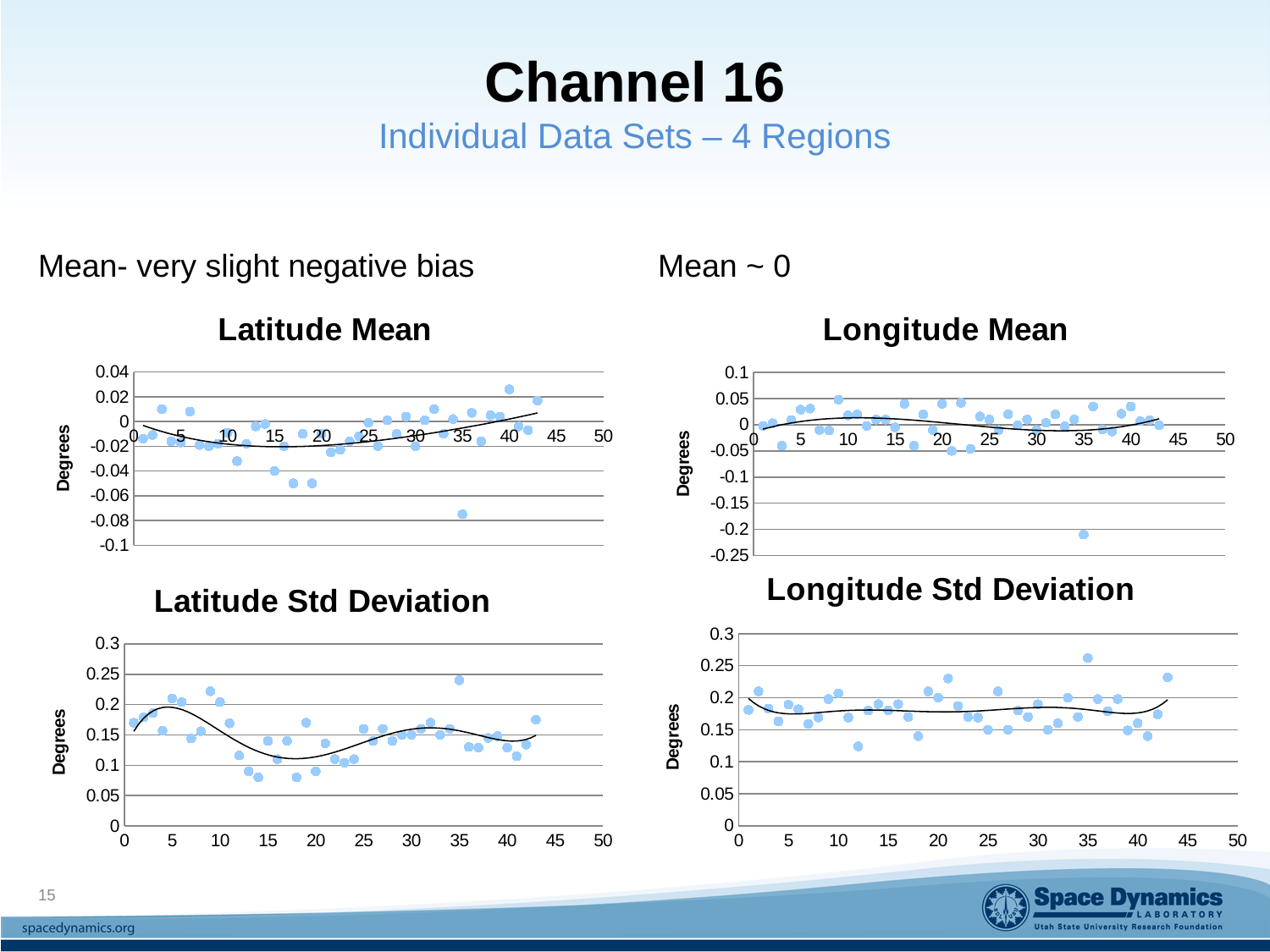
What is the title of the top-right chart? Longitude Mean In the Latitude Std Deviation chart, is the lowest plotted point greater or less than 0.1? less What kind of chart is the Longitude Std Deviation chart? scatter chart In the Longitude Mean chart, is the lowest plotted point greater or less than -0.15? less What is the y-axis label of the Latitude Std Deviation chart? Degrees In the Latitude Mean chart, is the lowest plotted point greater or less than -0.06? less How many charts are shown on the slide? 4 What kind of chart is the Latitude Mean chart? scatter chart